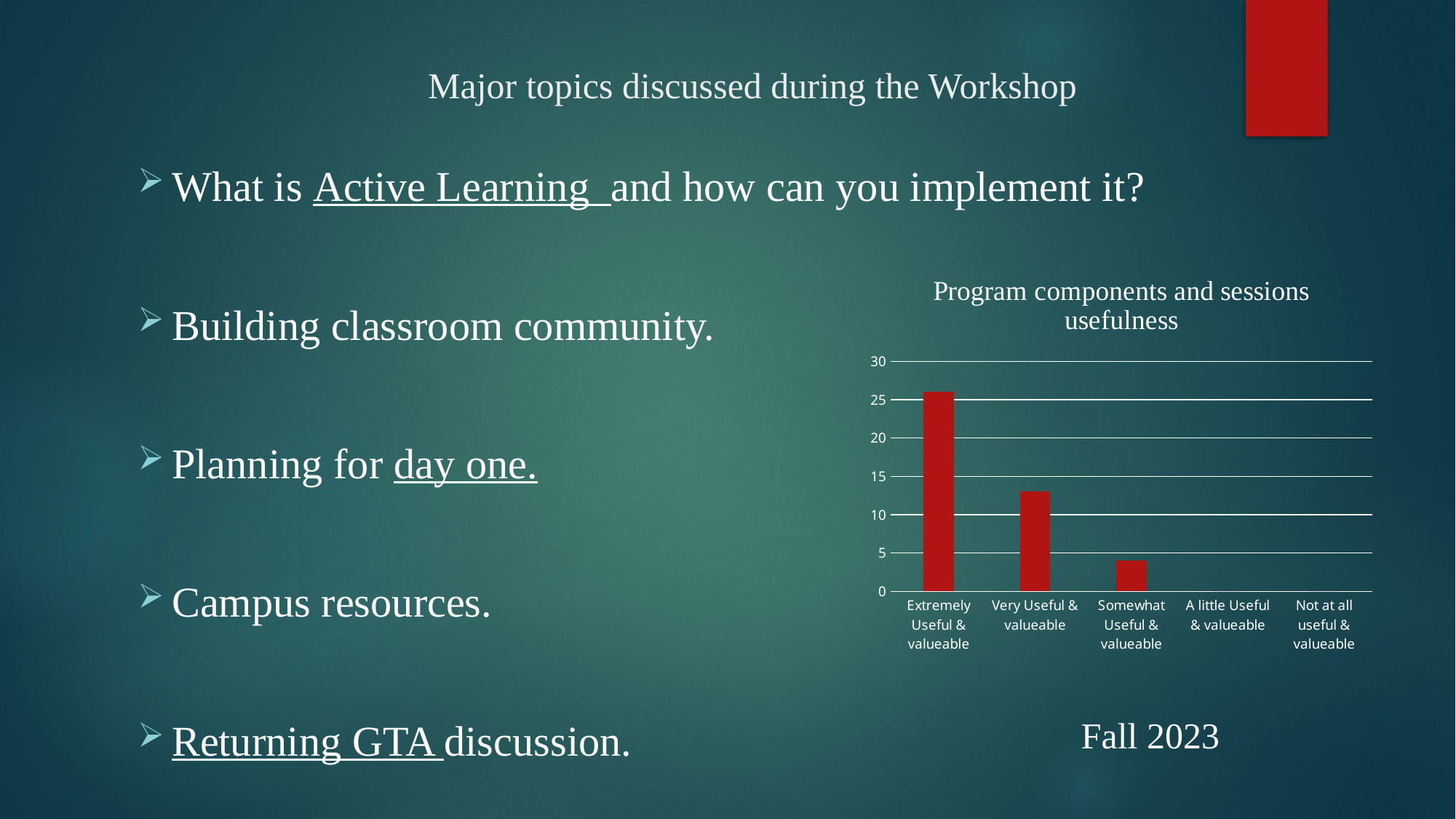
Is the value for Somewhat Useful & valueable greater or less than 5? less Is the value for A little Useful & valueable greater or less than 5? less How many categories are shown on the x axis of the chart? 5 Is the value for Very Useful & valueable greater or less than 15? less What is the title of the chart on the slide? Program components and sessions usefulness Which category has the highest value in the chart? Extremely Useful & valueable What kind of chart is shown on the slide? bar chart What colour are the bars in the chart? red Do the values rise or fall moving from left to right along the x axis? fall Which is larger, the value for Extremely Useful & valueable or the value for Very Useful & valueable? Extremely Useful & valueable